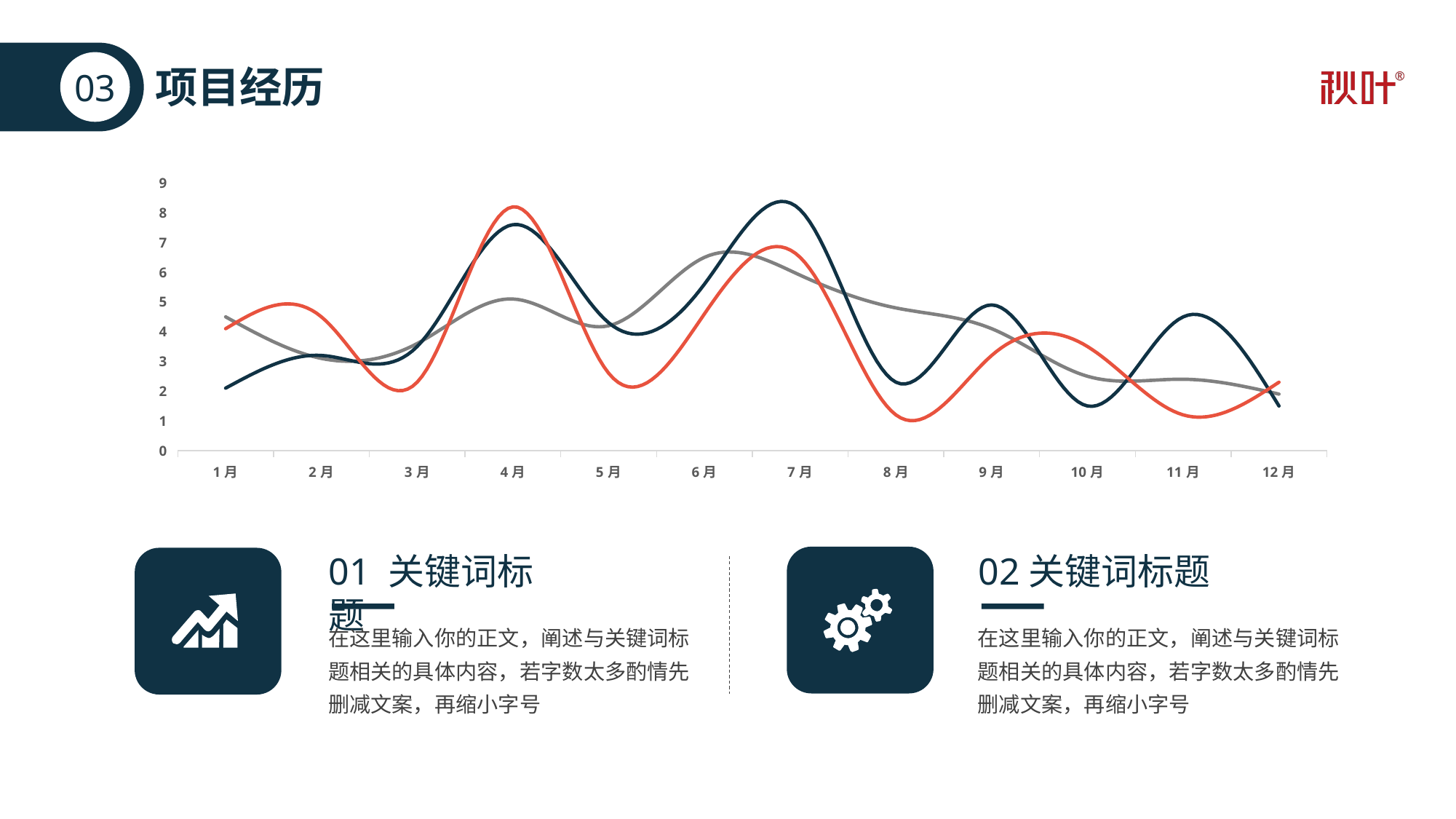
How many months are shown on the x axis of the chart? 12 In which month does the dark blue line reach its highest point? 7月 Does the dark blue line rise or fall from 7月 to 8月? fall Is the value of the dark blue line at 1月 greater or less than 3? less Is the value of the red line at 4月 greater or less than 7? greater In which month does the red line reach its highest point? 4月 At 8月, which line is higher, the gray line or the red line? the gray line How many lines are plotted on the chart? 3 What kind of chart is shown on the slide? line chart Is the value of the red line at 8月 greater or less than 2? less At 7月, which line is higher, the dark blue line or the red line? the dark blue line